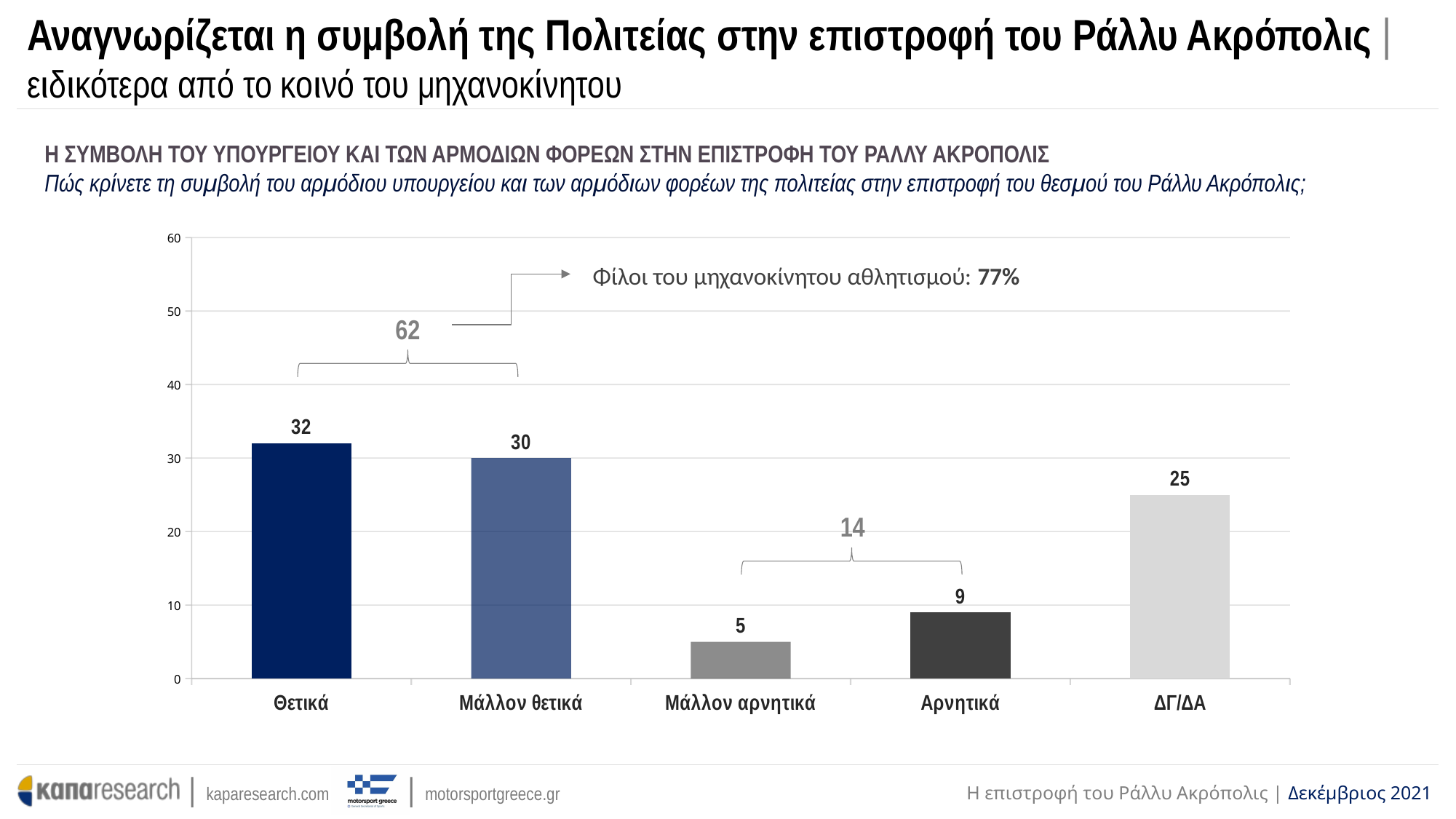
What is the value for ΔΓ/ΔΑ? 25 What combined value does the bracket above Θετικά and Μάλλον θετικά show? 62 What is the value for Μάλλον θετικά? 30 What is the difference between the values for Θετικά and ΔΓ/ΔΑ? 7 What is the value for Αρνητικά? 9 Which category has the lowest value? Μάλλον αρνητικά What kind of chart is shown on the slide? bar chart Which is larger, the value for Αρνητικά or the value for Μάλλον αρνητικά? Αρνητικά What is the value for Θετικά? 32 How many categories are shown on the x axis? 5 What is the value for Μάλλον αρνητικά? 5 Which category has the highest value? Θετικά